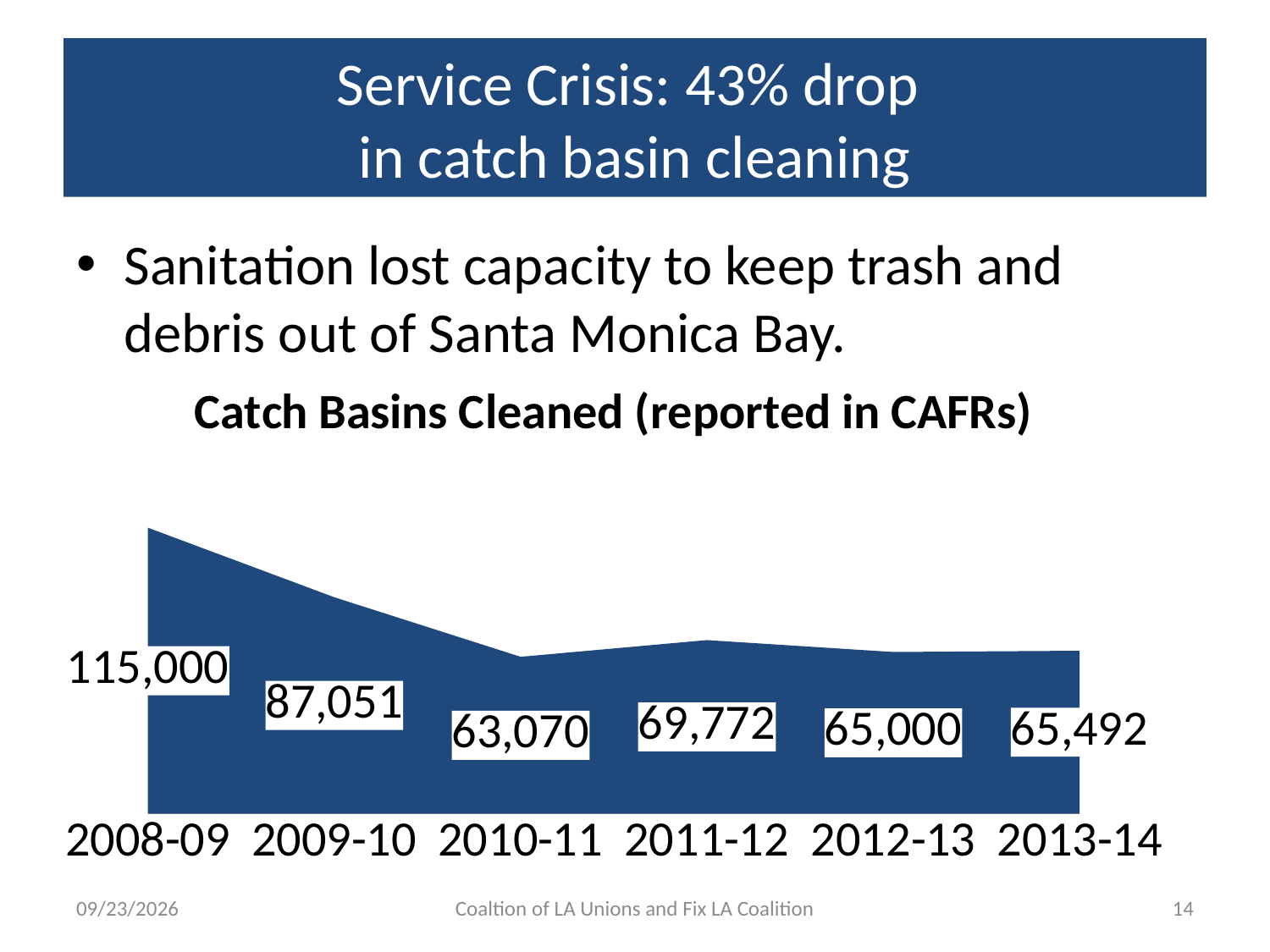
How many years are shown on the chart? 6 Which year has the highest number of catch basins cleaned? 2008-09 What is the number of catch basins cleaned in 2013-14? 65,492 What is the difference between the catch basins cleaned in 2011-12 and 2012-13? 4,772 Which year has the lowest number of catch basins cleaned? 2010-11 What is the number of catch basins cleaned in 2008-09? 115,000 What is the number of catch basins cleaned in 2010-11? 63,070 What kind of chart is shown on the slide? Area chart Which year had more catch basins cleaned, 2009-10 or 2011-12? 2009-10 What is the difference between the catch basins cleaned in 2008-09 and 2009-10? 27,949 Which year had more catch basins cleaned, 2012-13 or 2013-14? 2013-14 What is the title of the chart? Catch Basins Cleaned (reported in CAFRs)